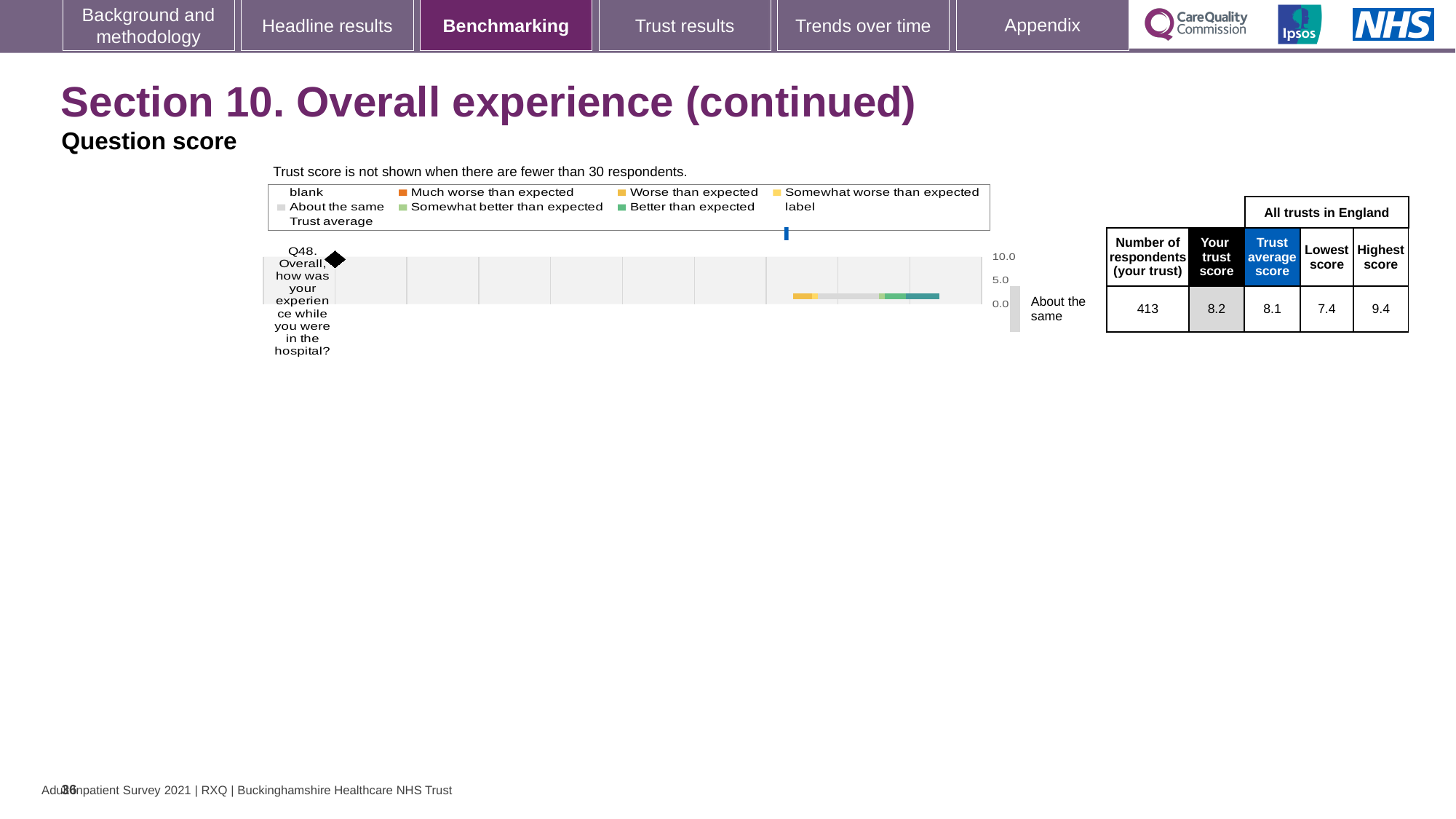
What is the difference between the highest score and the lowest score for Q48? 2.0 How many respondents from the trust answered Q48? 413 What is the lowest score among all trusts in England for Q48? 7.4 How many questions are plotted on the benchmarking chart? 1 What is the highest score among all trusts in England for Q48? 9.4 Which question number is plotted on the chart? Q48 What is the trust average score for Q48? 8.1 What type of chart is used to show the Q48 benchmarking result? bar chart What is the trust score for Q48 (Overall, how was your experience while you were in the hospital?)? 8.2 Which is larger for Q48: your trust score or the trust average score? Your trust score Is the trust score for Q48 greater or less than 5.0? greater What is the benchmark category shown for Q48? About the same